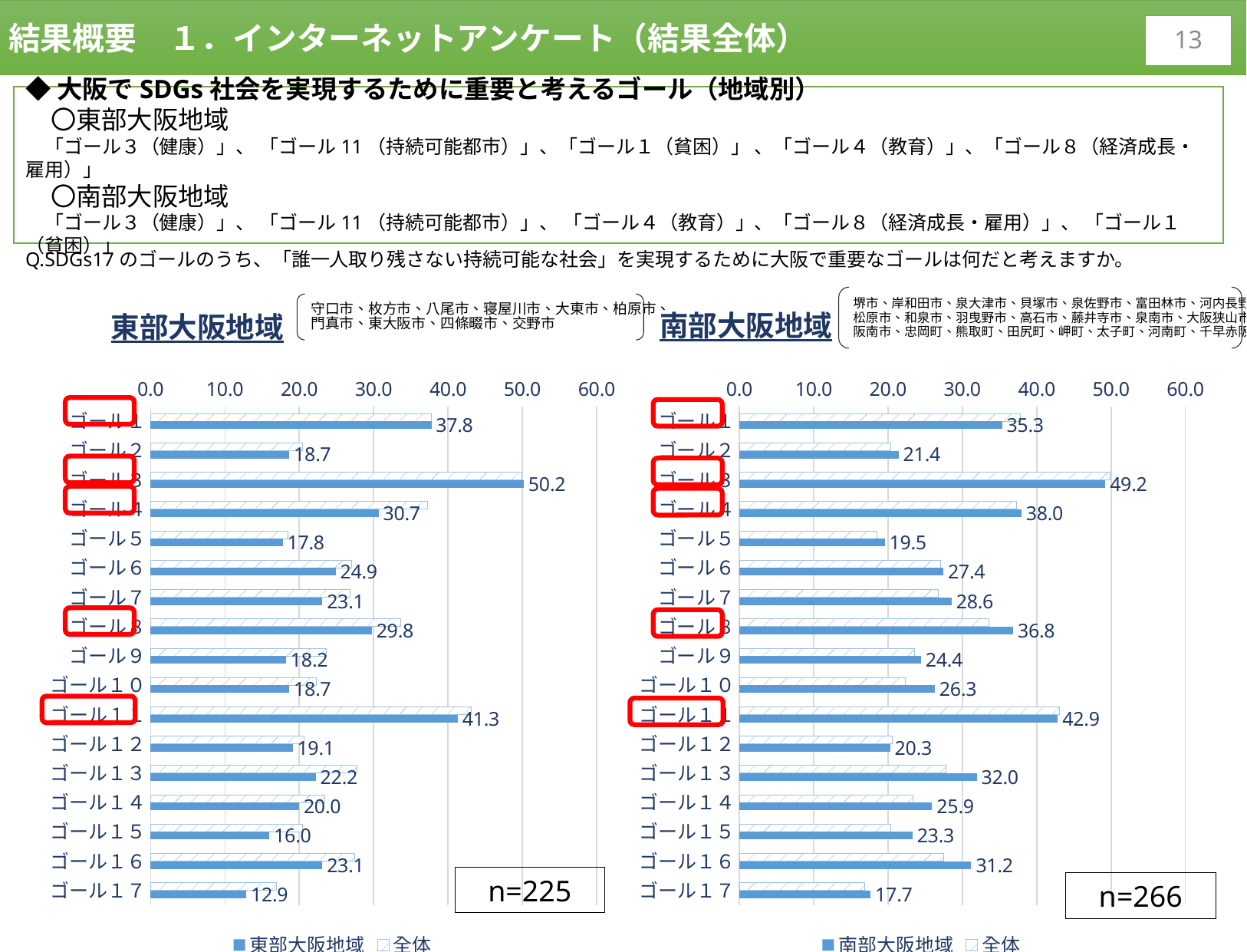
In the 南部大阪地域 chart, which goal has the highest value for the 南部大阪地域 series? ゴール３ In the 南部大阪地域 chart, what is the value for ゴール１１ for the 南部大阪地域 series? 42.9 In the 東部大阪地域 chart, is the 東部大阪地域 value for ゴール１ greater or less than 30.0? greater What sample size (n) is shown for the 東部大阪地域 chart? n=225 How many series does the legend of the 東部大阪地域 chart list? 2 What kind of chart is the 南部大阪地域 chart? bar chart In the 東部大阪地域 chart, what is the difference between the 東部大阪地域 values for ゴール３ and ゴール１１? 8.9 In the 東部大阪地域 chart, which goal has the lowest value for the 東部大阪地域 series? ゴール１７ In the 南部大阪地域 chart, which is larger for the 南部大阪地域 series: ゴール４ or ゴール８? ゴール４ In the 東部大阪地域 chart, what is the value for ゴール３ for the 東部大阪地域 series? 50.2 How many goal categories are shown in the 南部大阪地域 chart? 17 In the 南部大阪地域 chart, what is the value for ゴール１７ for the 南部大阪地域 series? 17.7